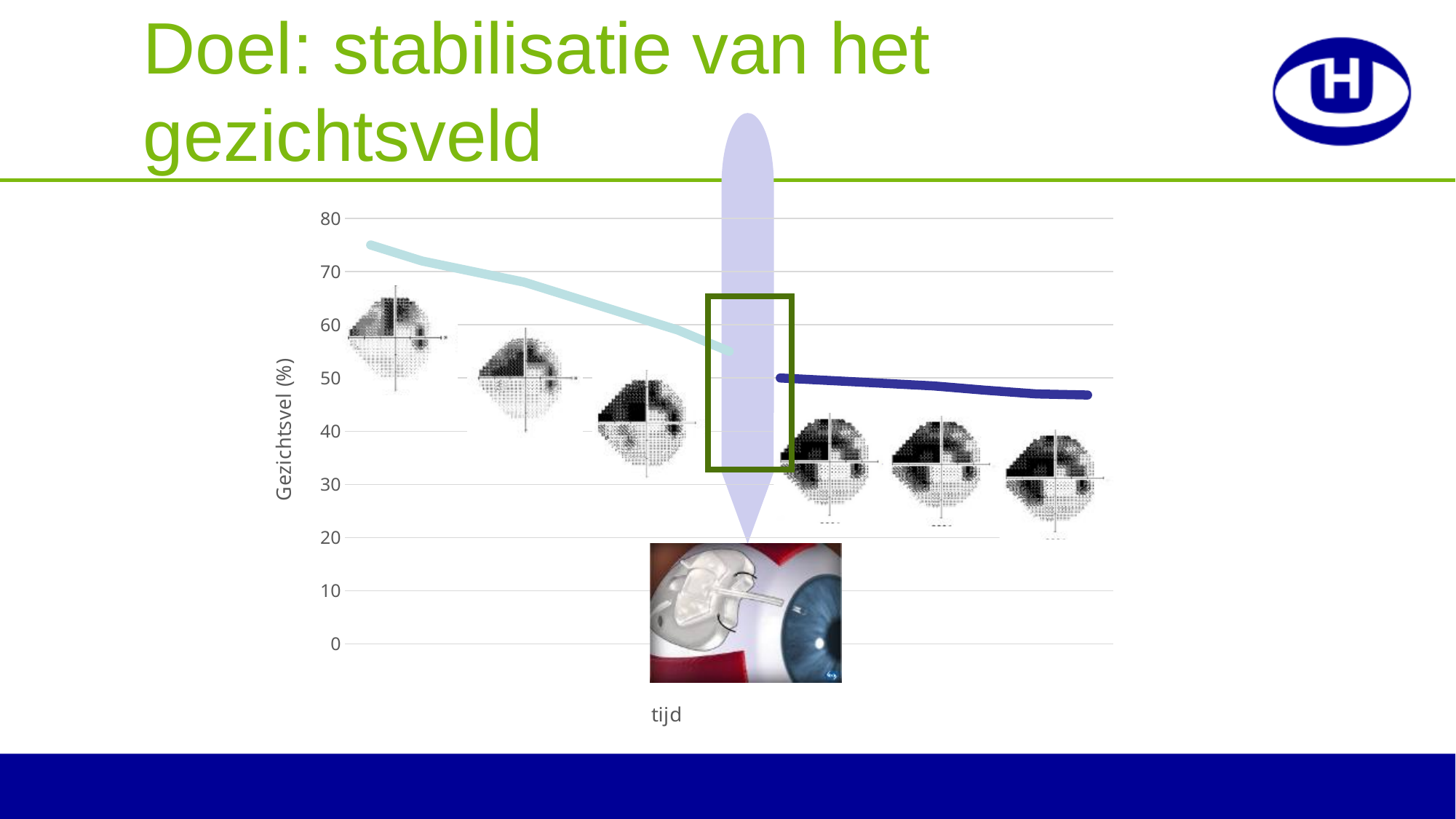
Is the value at the end of the dark blue line greater or less than 40? greater Is the value at the end of the light blue line greater or less than 60? less Is the value at the start of the light blue line greater or less than 70? greater What is the label of the x axis? tijd Which is higher: the start of the light blue line or the start of the dark blue line? the start of the light blue line Does the light blue line rise or fall along the x axis? fall What is the label of the y axis? Gezichtsvel (%) How many lines are plotted on the chart? 2 Which line shows the steeper decline, the light blue line or the dark blue line? the light blue line What kind of chart is shown on the slide? line chart Does the dark blue line rise or fall along the x axis? fall